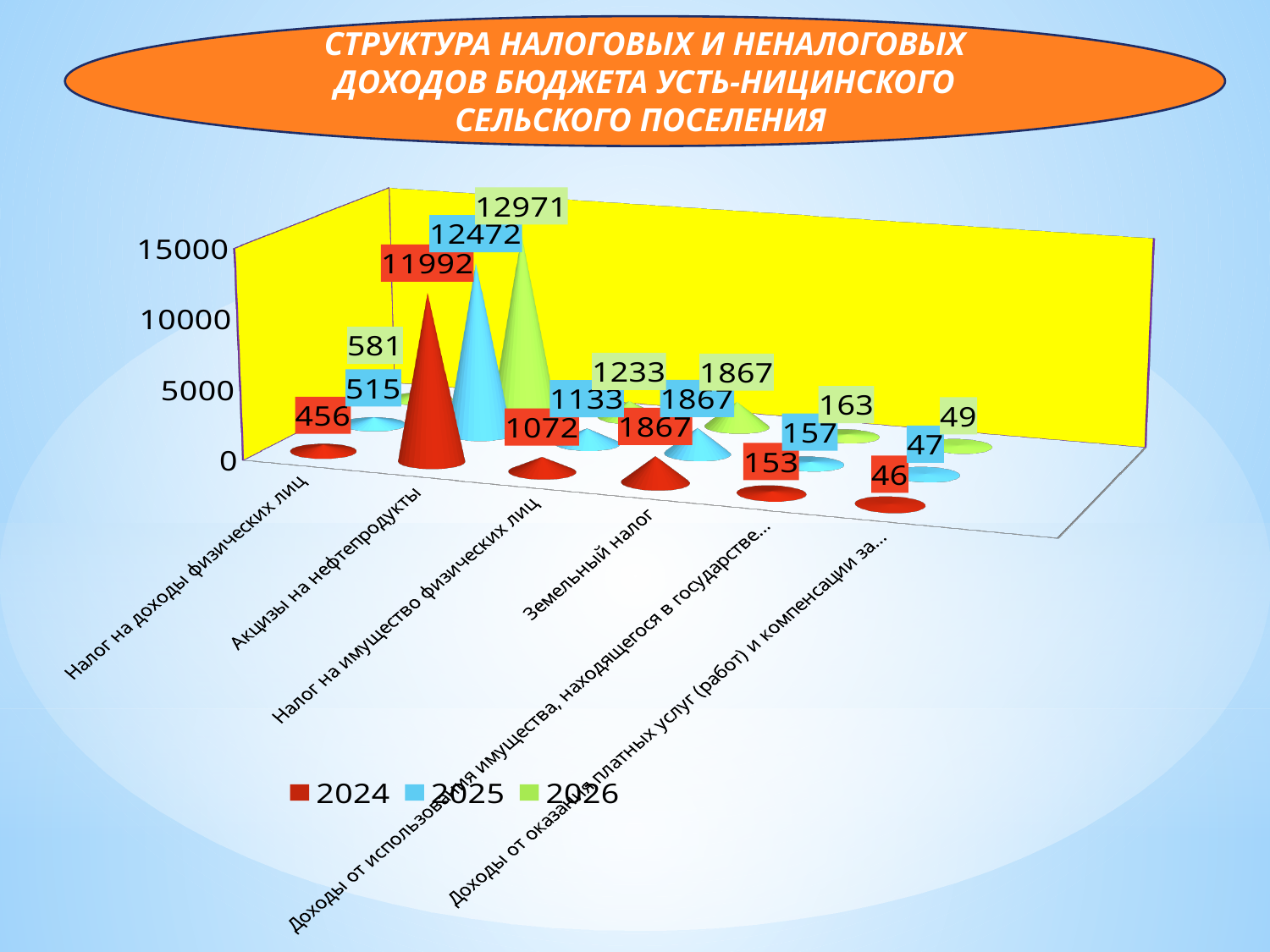
Which category has the highest value in 2026? Акцизы на нефтепродукты How many categories are shown on the x axis? 6 What is the difference between the 2026 and 2024 values for Акцизы на нефтепродукты? 979 What is the value for Налог на доходы физических лиц in 2026? 581 What is the value for Акцизы на нефтепродукты in 2024? 11992 What is the value for Налог на имущество физических лиц in 2025? 1133 What is the value for Земельный налог in 2025? 1867 How many series does the legend list? 3 Do the values for Налог на доходы физических лиц rise or fall from 2024 to 2026? rise Which is larger: the 2025 value for Налог на имущество физических лиц or the 2025 value for Земельный налог? Земельный налог Which category has the lowest value in 2024? Доходы от оказания платных услуг (работ) и компенсации за... Is the 2025 value for Акцизы на нефтепродукты greater or less than 10000? greater